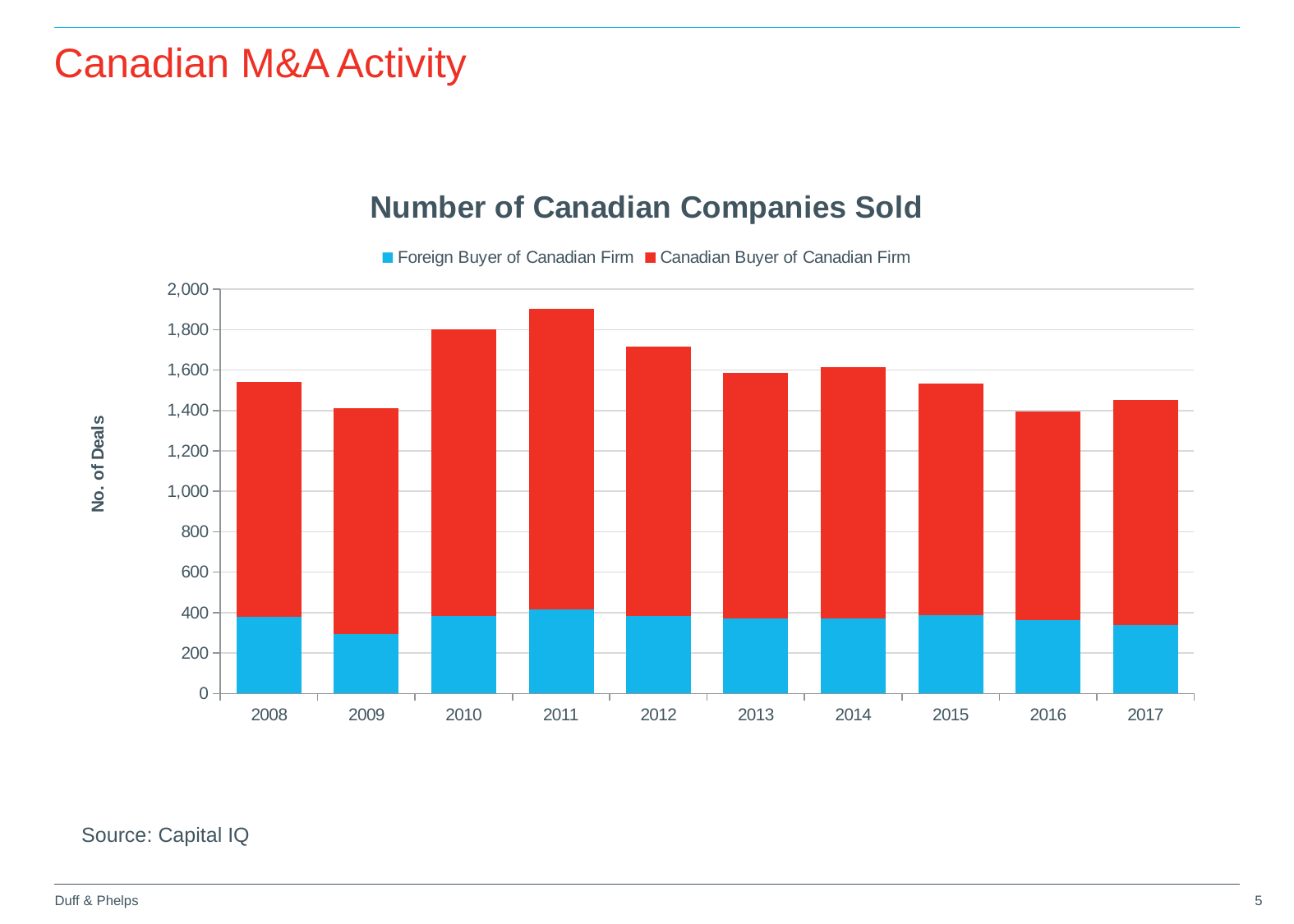
What kind of chart is shown on the slide? Stacked bar chart Do the total number of deals rise or fall from 2014 to 2016? fall How many years are shown on the x axis of the chart? 10 Is the value for Foreign Buyer of Canadian Firm in 2009 greater or less than 400? less Is the total number of deals in 2011 greater or less than 1,800? greater How many series does the chart's legend list? 2 Is the total number of deals in 2009 greater or less than 1,600? less Which year has the highest total number of Canadian companies sold? 2011 Which year has the lowest value for Foreign Buyer of Canadian Firm? 2009 Which year has the highest value for Foreign Buyer of Canadian Firm? 2011 Which year has a larger total number of deals, 2010 or 2013? 2010 What is the label on the y axis of the chart? No. of Deals